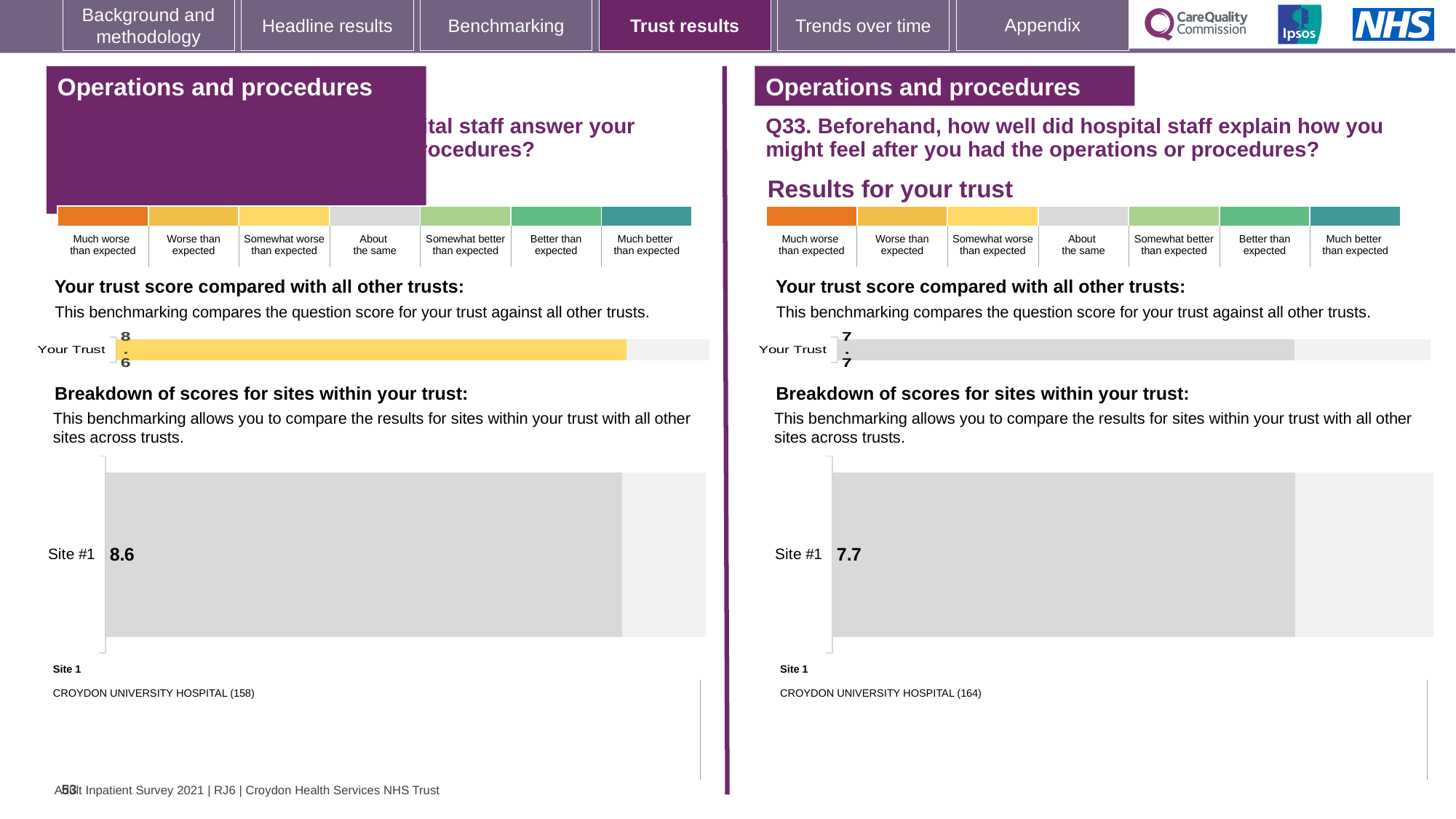
On the left-hand slide, what is the score for Site #1 in the breakdown of scores for sites within your trust? 8.6 How many sites are shown in the breakdown of scores on the right-hand slide (Q33)? 1 What is the difference between the Site #1 score on the left-hand slide and the Site #1 score on the right-hand slide (Q33)? 0.9 On the left-hand slide, how many respondents are shown in brackets for Croydon University Hospital (Site 1)? 158 On the left-hand slide, what is the score shown for Your Trust? 8.6 On the right-hand slide (Q33), what is the score for Site #1 in the breakdown of scores for sites within your trust? 7.7 On the right-hand slide (Q33), which benchmark category does the grey colour of the Your Trust bar correspond to? About the same On the right-hand slide (Q33), what is the score shown for Your Trust? 7.7 Which is larger: the Your Trust score on the left-hand slide or the Your Trust score on the right-hand slide (Q33)? Left-hand slide (8.6) On the right-hand slide (Q33), which site is listed as Site 1? CROYDON UNIVERSITY HOSPITAL (164) On the left-hand slide, which benchmark category does the yellow colour of the Your Trust bar correspond to? Somewhat worse than expected What type of chart is used to show the Your Trust score on the left-hand slide? Bar chart